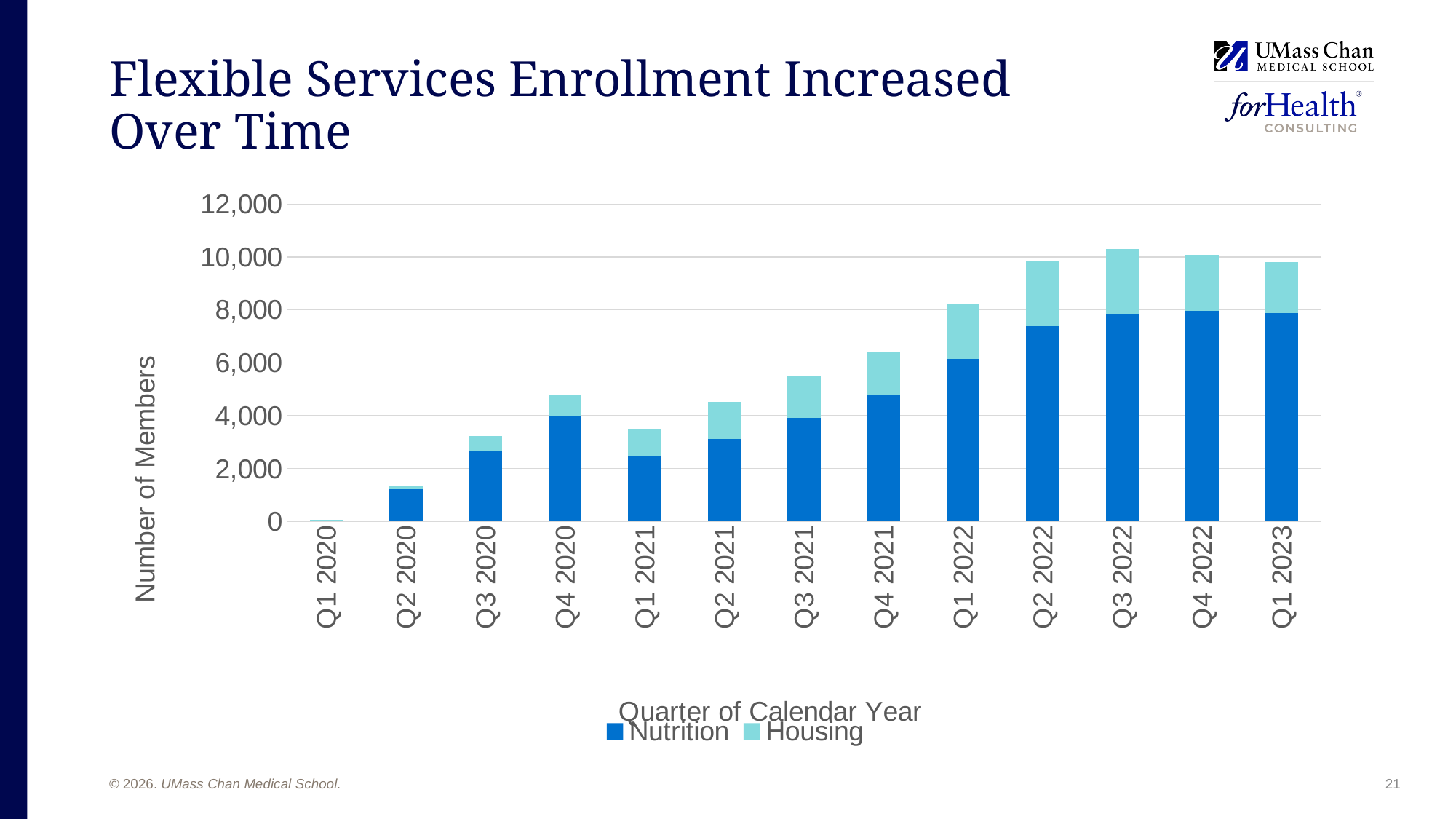
Is the total number of members in Q2 2022 greater or less than 8,000? greater Is the total number of members in Q1 2021 greater or less than 4,000? less Overall, do total enrollments rise or fall from Q1 2020 to Q1 2023? Rise What is the title of the y axis? Number of Members Is the total number of members in Q4 2020 greater or less than 4,000? greater What kind of chart is shown on the slide? Stacked bar chart Which quarter has the highest total number of members? Q3 2022 How many series does the legend list? 2 Which quarter has the lowest total number of members? Q1 2020 Which quarter has a larger total number of members, Q4 2020 or Q1 2021? Q4 2020 How many quarters are plotted along the x axis? 13